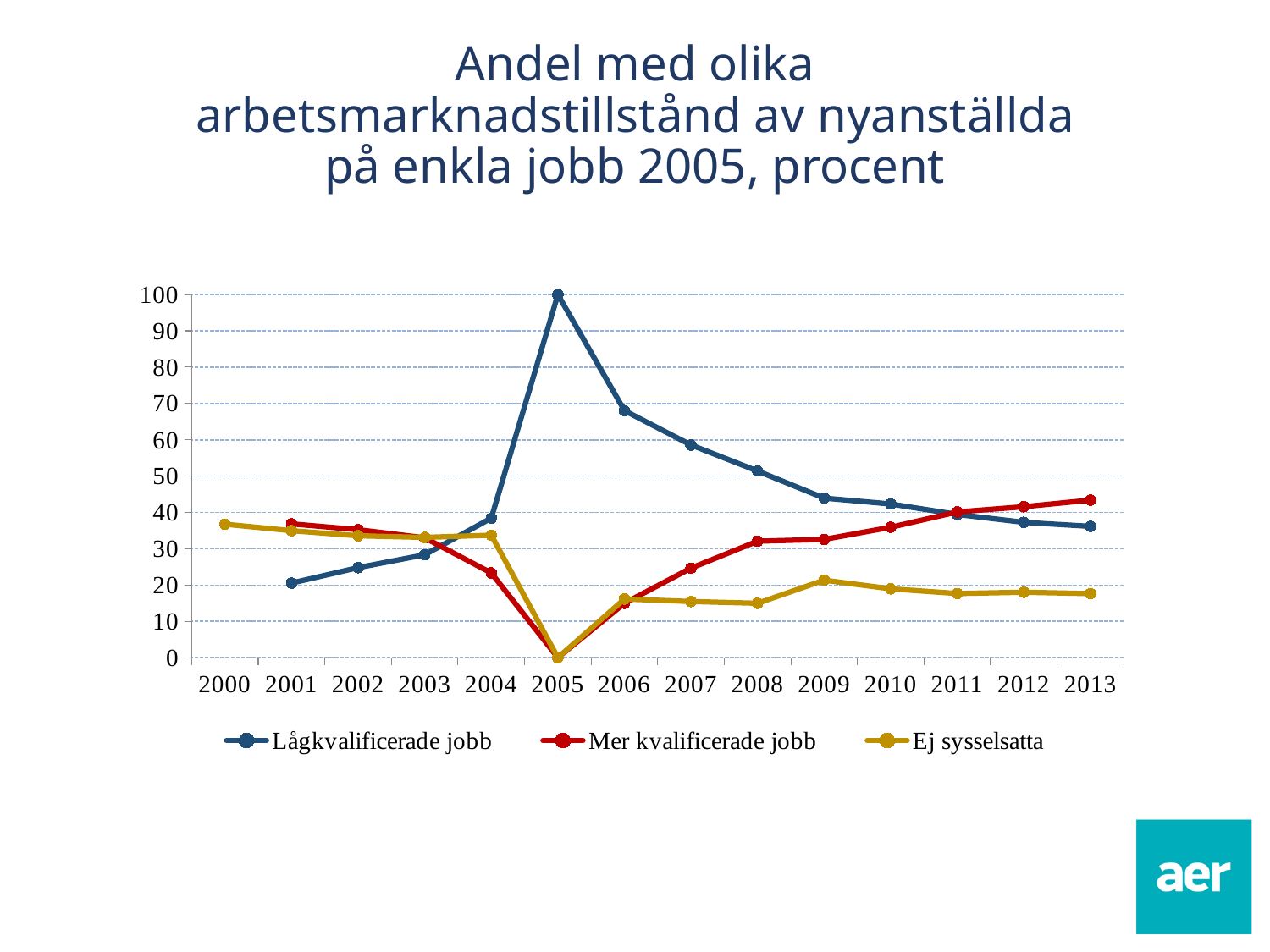
Which series is drawn in red? Mer kvalificerade jobb What kind of chart is shown on the slide? line chart In 2013, which series has the larger value, Mer kvalificerade jobb or Lågkvalificerade jobb? Mer kvalificerade jobb How many years are shown on the x axis? 14 How many series does the legend list? 3 In which year does Lågkvalificerade jobb reach its highest value? 2005 What is the value for Mer kvalificerade jobb in 2005? 0 Does the value for Lågkvalificerade jobb rise or fall from 2005 to 2013? fall Is the value for Lågkvalificerade jobb in 2006 greater or less than 60? greater In which year does Ej sysselsatta reach its lowest value? 2005 What is the value for Lågkvalificerade jobb in 2005? 100 Is the value for Ej sysselsatta in 2008 greater or less than 20? less